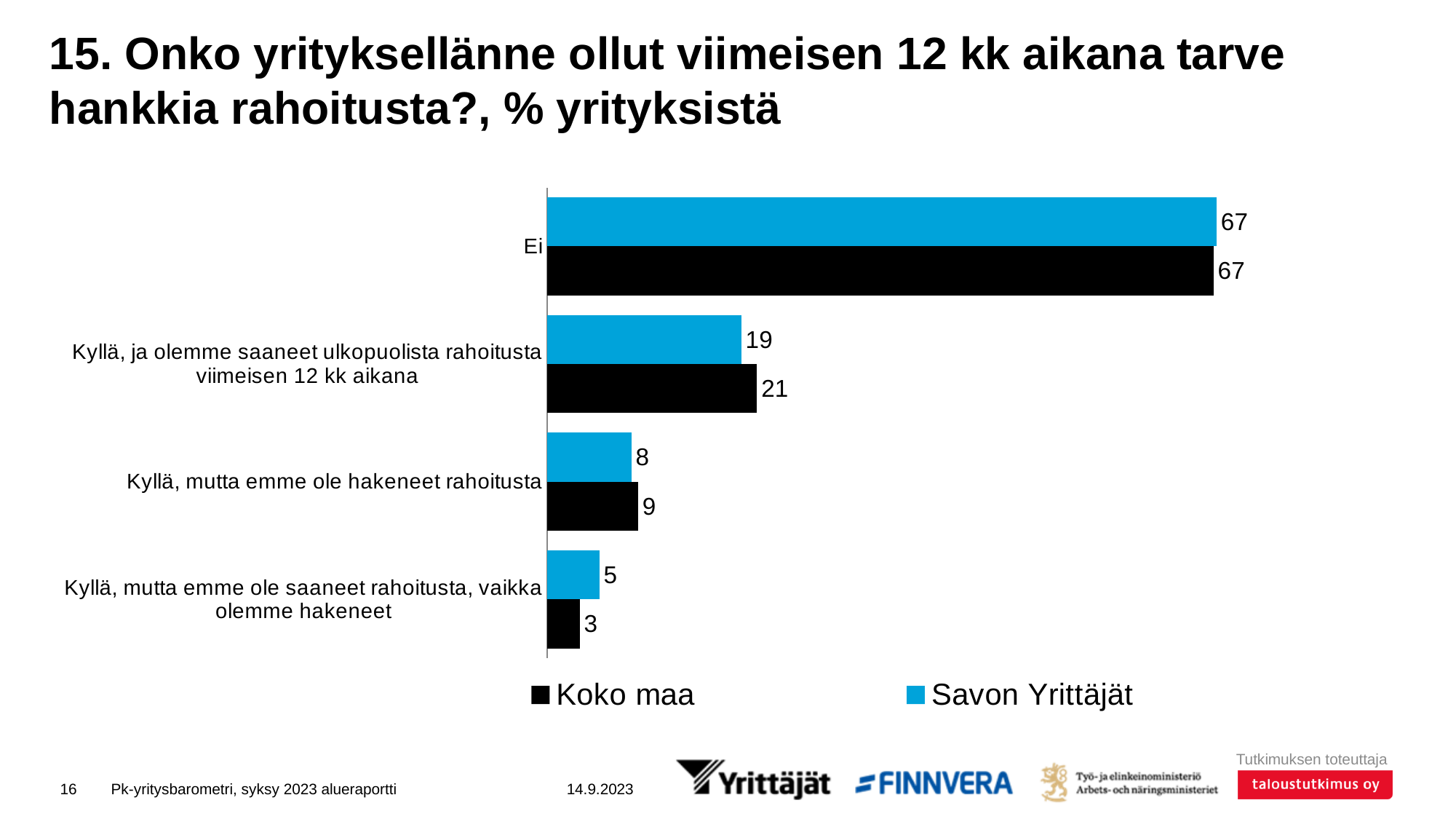
What is the value for Savon Yrittäjät in the category "Kyllä, mutta emme ole hakeneet rahoitusta"? 8 What is the value for Koko maa in the category "Kyllä, mutta emme ole saaneet rahoitusta, vaikka olemme hakeneet"? 3 What is the value for Savon Yrittäjät in the "Ei" category? 67 What kind of chart is shown on the slide? Bar chart Which category has the lowest value for Savon Yrittäjät? Kyllä, mutta emme ole saaneet rahoitusta, vaikka olemme hakeneet Which category has the highest value for Koko maa? Ei How many categories are shown on the chart? 4 What is the value for Koko maa in the category "Kyllä, ja olemme saaneet ulkopuolista rahoitusta viimeisen 12 kk aikana"? 21 In the category "Kyllä, mutta emme ole saaneet rahoitusta, vaikka olemme hakeneet", which series has the larger value, Koko maa or Savon Yrittäjät? Savon Yrittäjät What is the difference between Koko maa and Savon Yrittäjät in the category "Kyllä, ja olemme saaneet ulkopuolista rahoitusta viimeisen 12 kk aikana"? 2 Which colour represents Savon Yrittäjät in the chart? Blue How many series does the legend list? 2